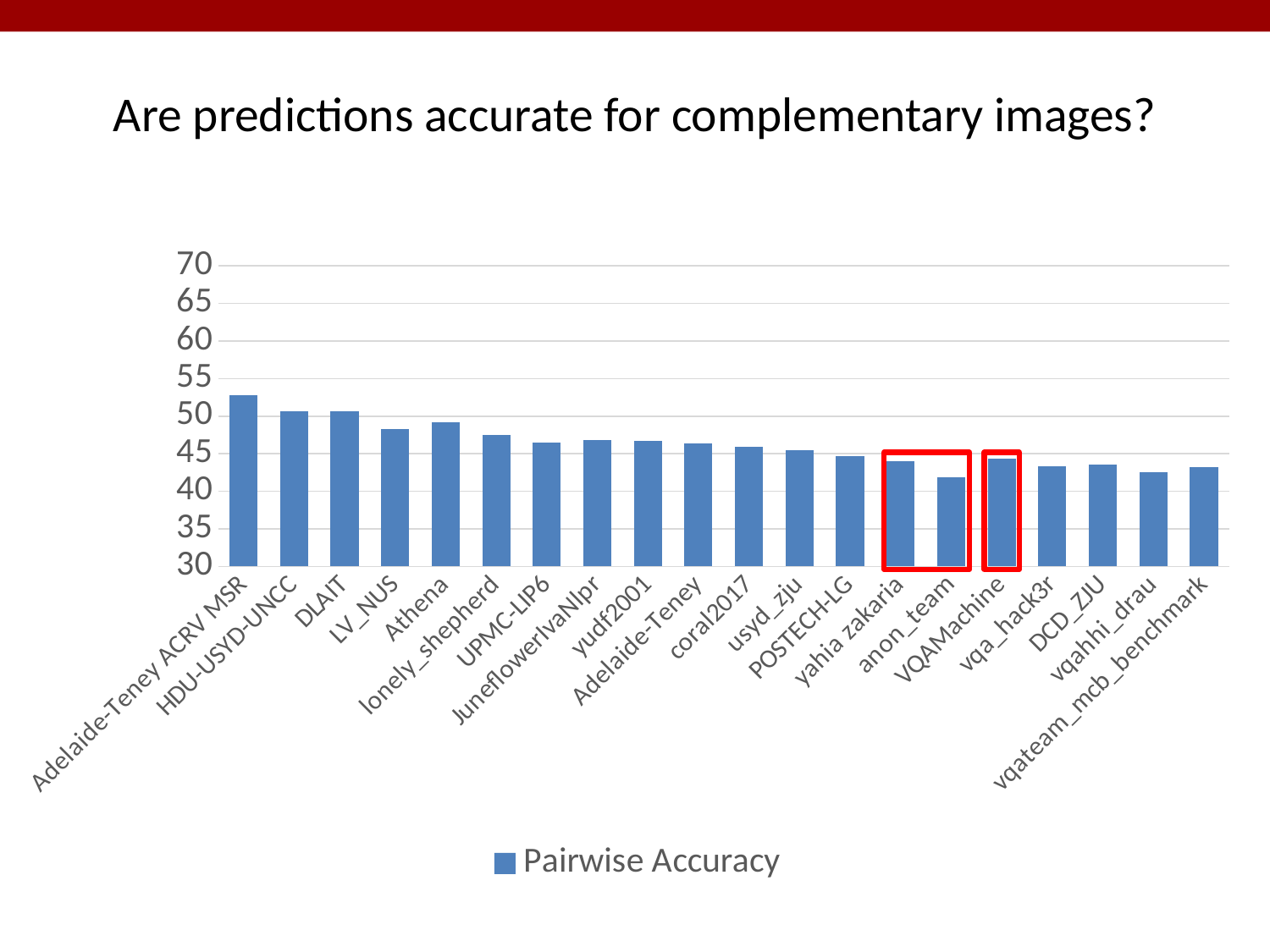
Is the value for Athena greater or less than 50? less Which has a higher Pairwise Accuracy, Athena or LV_NUS? Athena Which team has the highest Pairwise Accuracy? Adelaide-Teney ACRV MSR What is the name of the series shown in the legend? Pairwise Accuracy What kind of chart is shown on the slide? Bar chart How many series does the legend list? 1 Is the value for Adelaide-Teney ACRV MSR greater or less than 50? greater How many teams (categories) are plotted on the x axis? 20 Do the Pairwise Accuracy values generally rise or fall from left to right along the x axis? Fall Is the value for anon_team greater or less than 45? less Which team has the lowest Pairwise Accuracy? anon_team